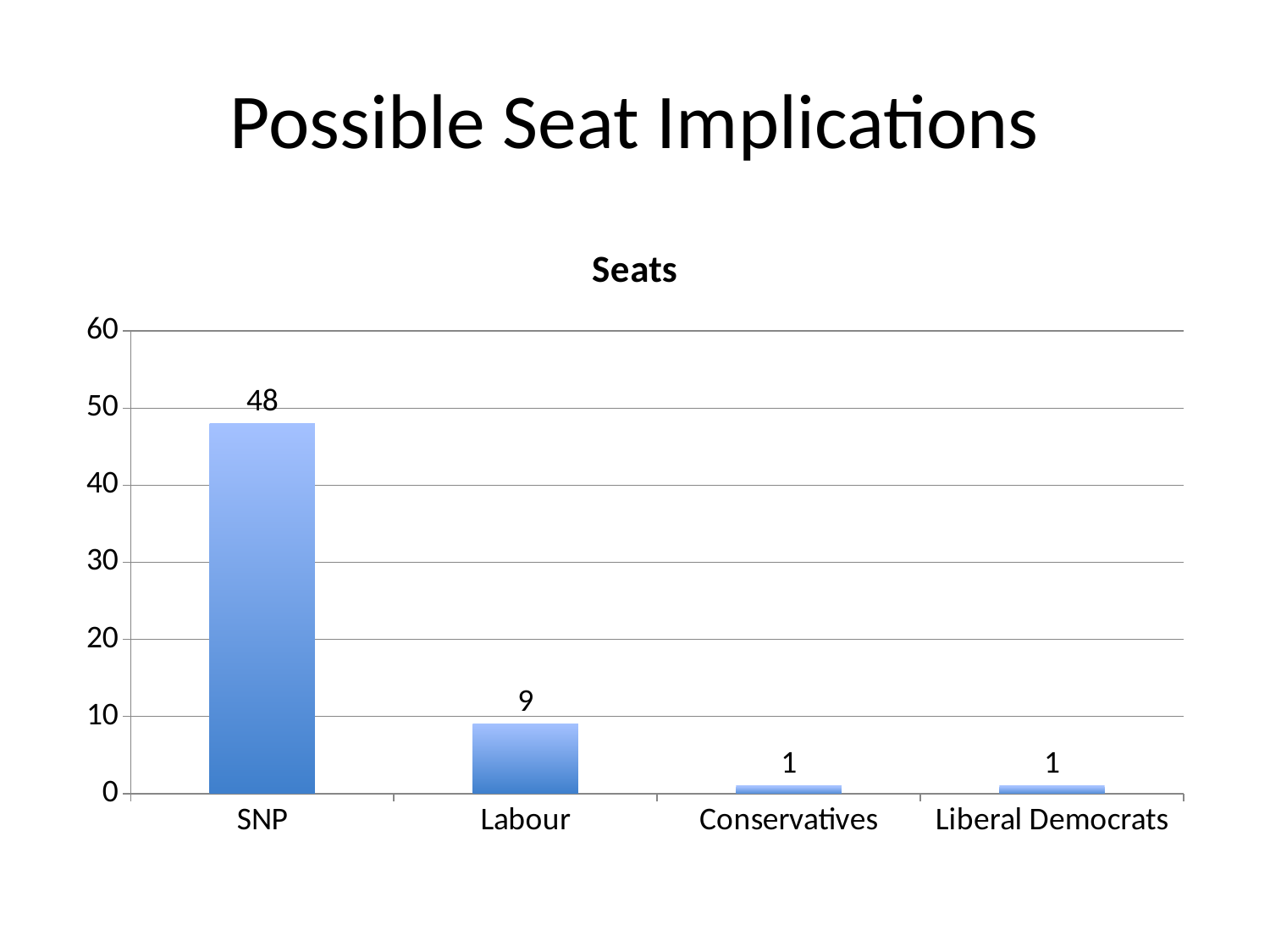
What is the title of the chart? Seats What is the value for Liberal Democrats? 1 What is the value for Labour? 9 Which is larger, the value for Labour or the value for Conservatives? Labour What is the value for SNP? 48 What is the value for Conservatives? 1 Is the value for SNP greater or less than 40? greater Which category has the highest value? SNP How many categories are shown on the x axis? 4 Do the values rise or fall from left to right along the x axis? fall What kind of chart is shown? bar chart What is the difference between the values for SNP and Labour? 39